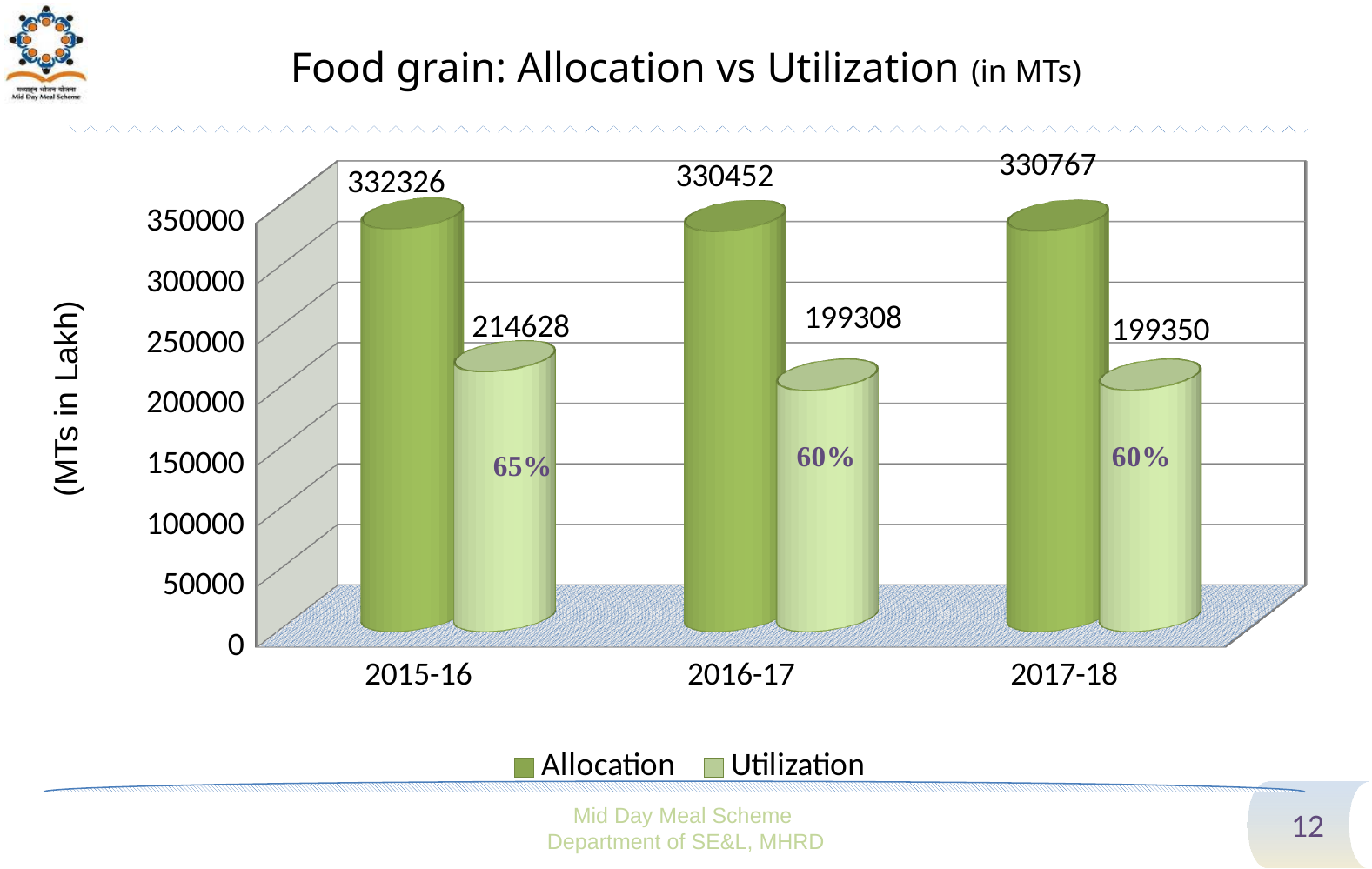
What is the Utilization value for 2016-17? 199308 What kind of chart is shown on the slide? Bar chart Which year has the highest Utilization value? 2015-16 Which year has the highest Allocation value? 2015-16 What is the difference between Allocation and Utilization in 2015-16? 117698 What is the difference between Allocation and Utilization in 2016-17? 131144 What is the Utilization value for 2017-18? 199350 How many series does the legend list? 2 What percentage is printed on the Utilization bar for 2015-16? 65% Which is larger in 2017-18, Allocation or Utilization? Allocation How many years are shown on the x axis? 3 What is the Allocation value for 2015-16? 332326